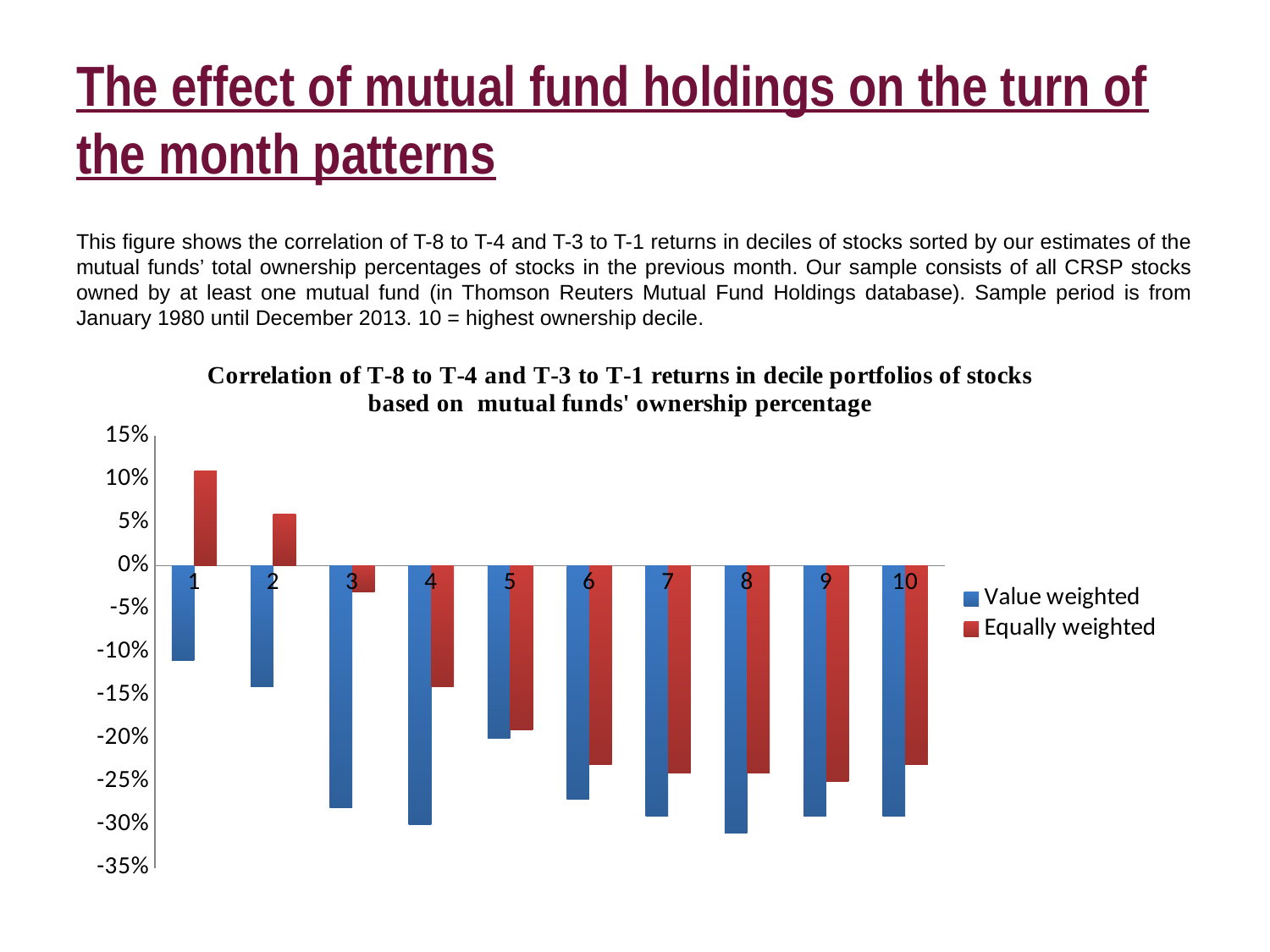
Do the Equally weighted values generally rise or fall from decile 1 to decile 10? fall Is the Value weighted value for decile 4 greater or less than -25%? less Is the Value weighted value for decile 5 greater or less than -15%? less Which decile has the highest Value weighted value? 1 Which decile has the highest Equally weighted value? 1 Is the Equally weighted value for decile 1 greater or less than 5%? greater What colour represents the Value weighted series in the legend? blue How many decile categories are plotted along the x axis? 10 For decile 4, which series has the larger value, Value weighted or Equally weighted? Equally weighted How many series does the legend list? 2 What kind of chart is shown on the slide? bar chart